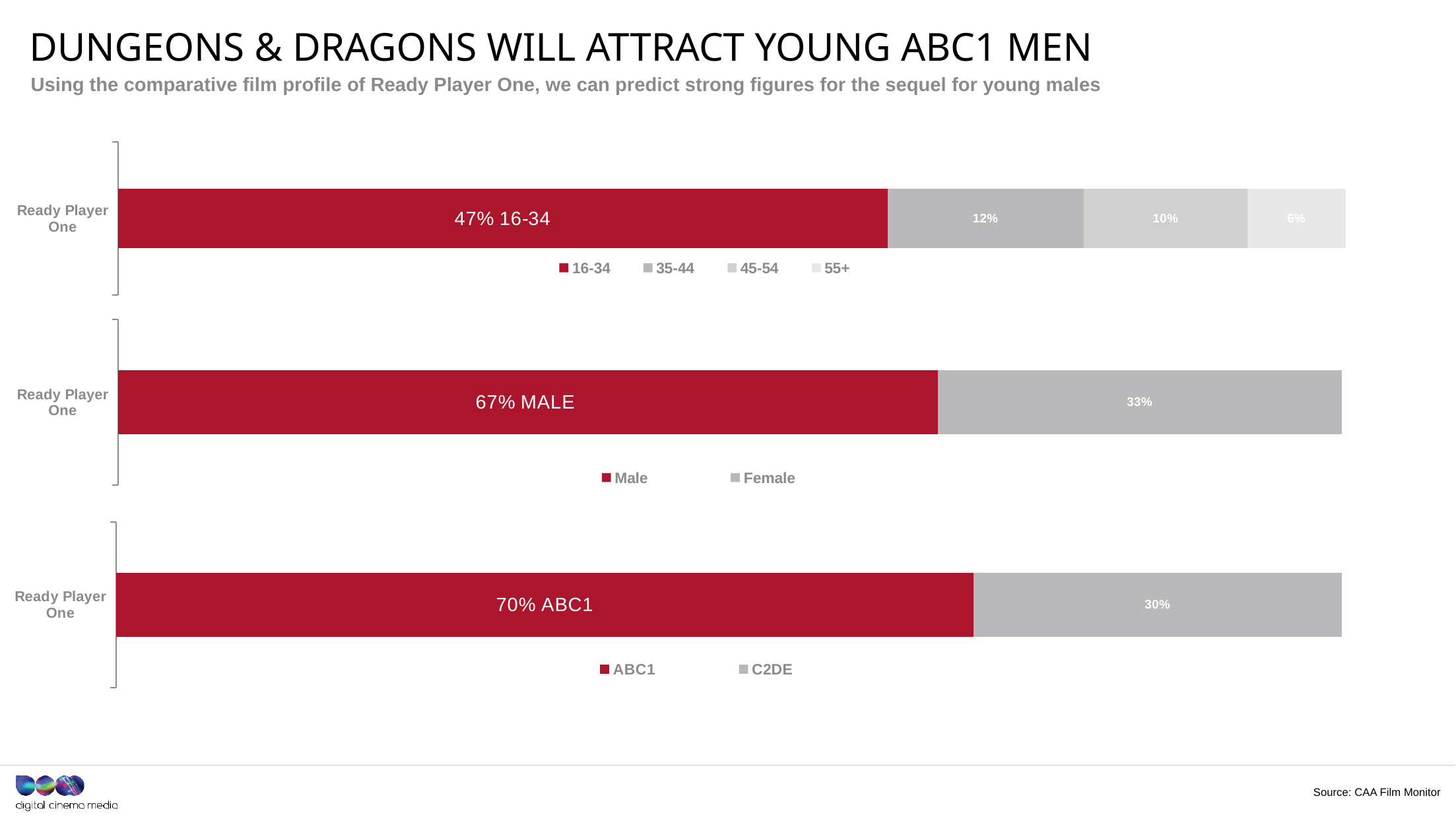
In the top chart (age groups), which age group has the largest share? 16-34 In the top chart (age groups), what share of the Ready Player One audience is 55+? 6% In the top chart (age groups), what share of the Ready Player One audience is 35-44? 12% What kind of chart is used in the middle chart (gender)? Stacked bar chart In the middle chart (gender), what is the difference between the male and female shares? 34% In the top chart (age groups), what is the difference between the 35-44 share and the 45-54 share? 2% In the top chart (age groups), how many series does the legend list? 4 In the bottom chart (social grade), what share of the Ready Player One audience is C2DE? 30% In the bottom chart (social grade), which is larger, the ABC1 share or the C2DE share? ABC1 In the middle chart (gender), what share of the Ready Player One audience is female? 33% In the top chart (age groups), which age group has the smallest share? 55+ In the top chart (age groups), what share of the Ready Player One audience is 16-34? 47%